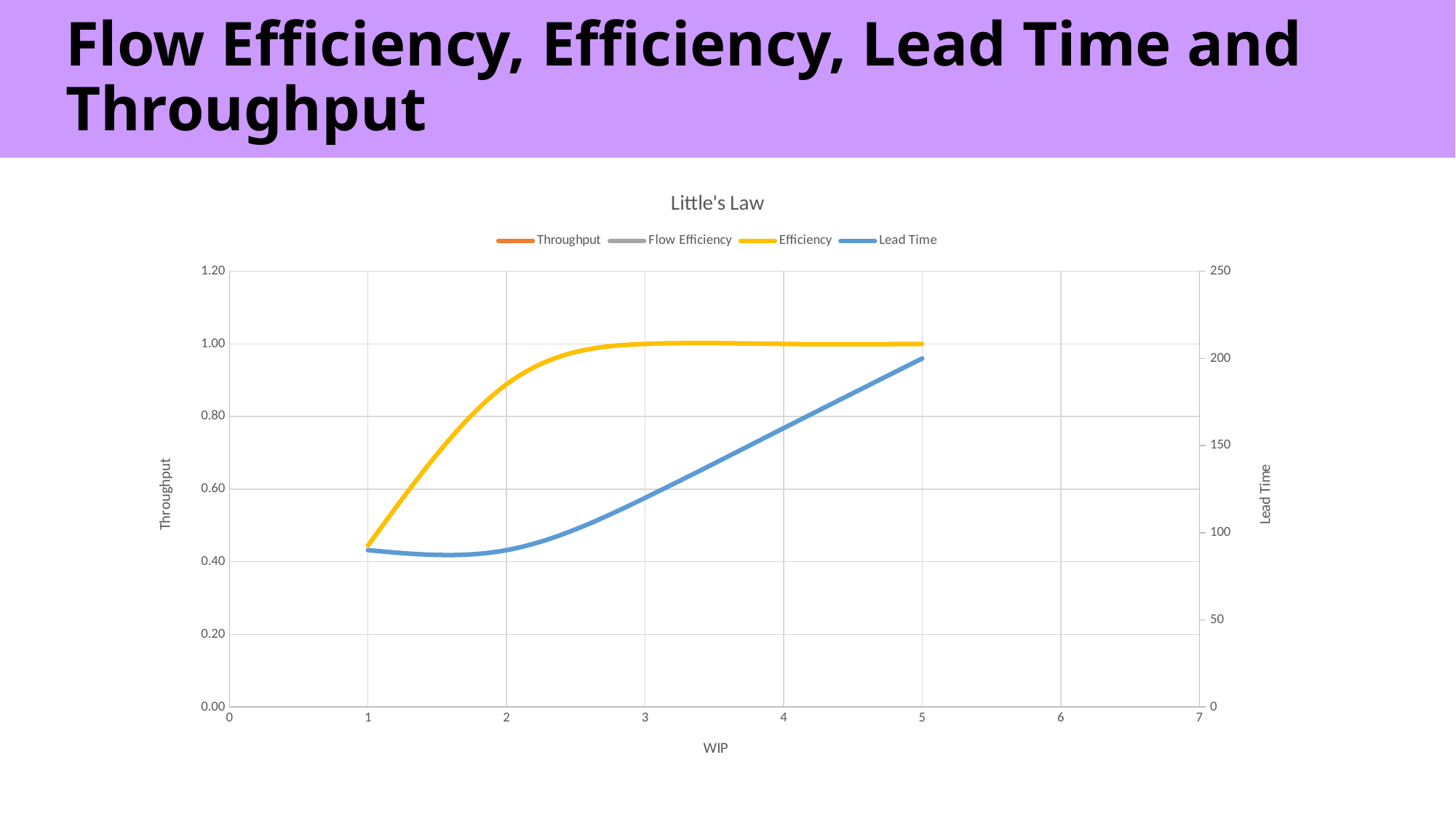
What is the label of the x axis of the chart? WIP What is the title of the chart? Little's Law Is the Efficiency value at WIP 1 greater or less than 0.60? less Is the Lead Time value at WIP 4 greater or less than 100? greater Does the Lead Time line rise or fall as WIP increases from 2 to 5? rise What kind of chart is shown on the slide? line chart Is the Lead Time value at WIP 5 greater or less than 150? greater Is the Efficiency value larger at WIP 1 or at WIP 2? WIP 2 How many series does the legend of the chart list? 4 Does the Efficiency line rise or fall as WIP increases from 1 to 3? rise